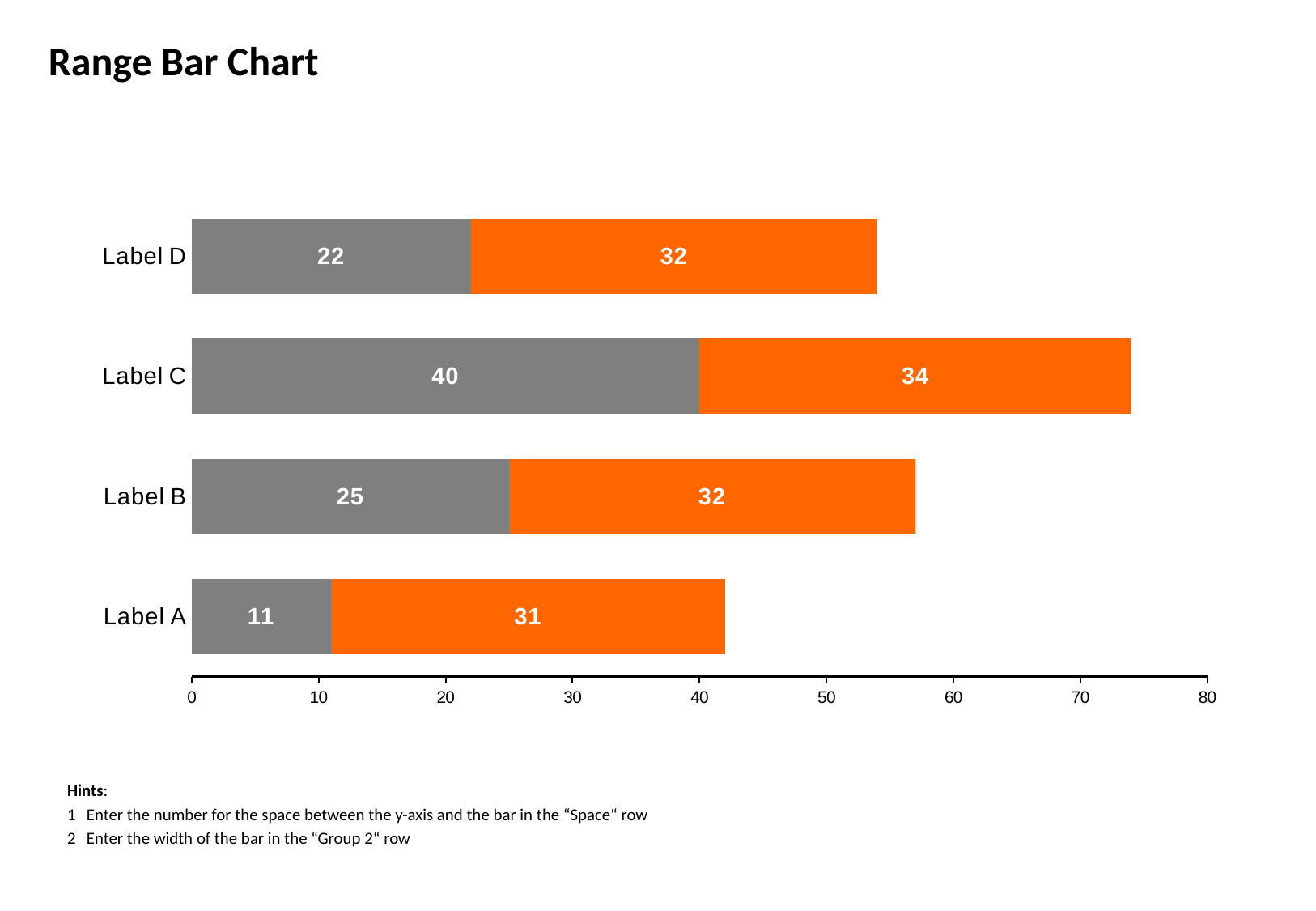
Which label has the largest orange segment? Label C What is the value of the gray segment for Label C? 40 What is the difference between the gray segment of Label C and the gray segment of Label B? 15 What is the value of the orange segment for Label A? 31 What is the total of the two segments for Label D? 54 What is the title of the chart? Range Bar Chart Which label has the smallest gray segment? Label A What is the total of the two segments for Label C? 74 Does the bar for Label C end at a value greater or less than 70 on the axis? greater What kind of chart is shown on the slide? bar chart Which has the larger gray segment, Label B or Label D? Label B How many labelled categories does the chart show? 4